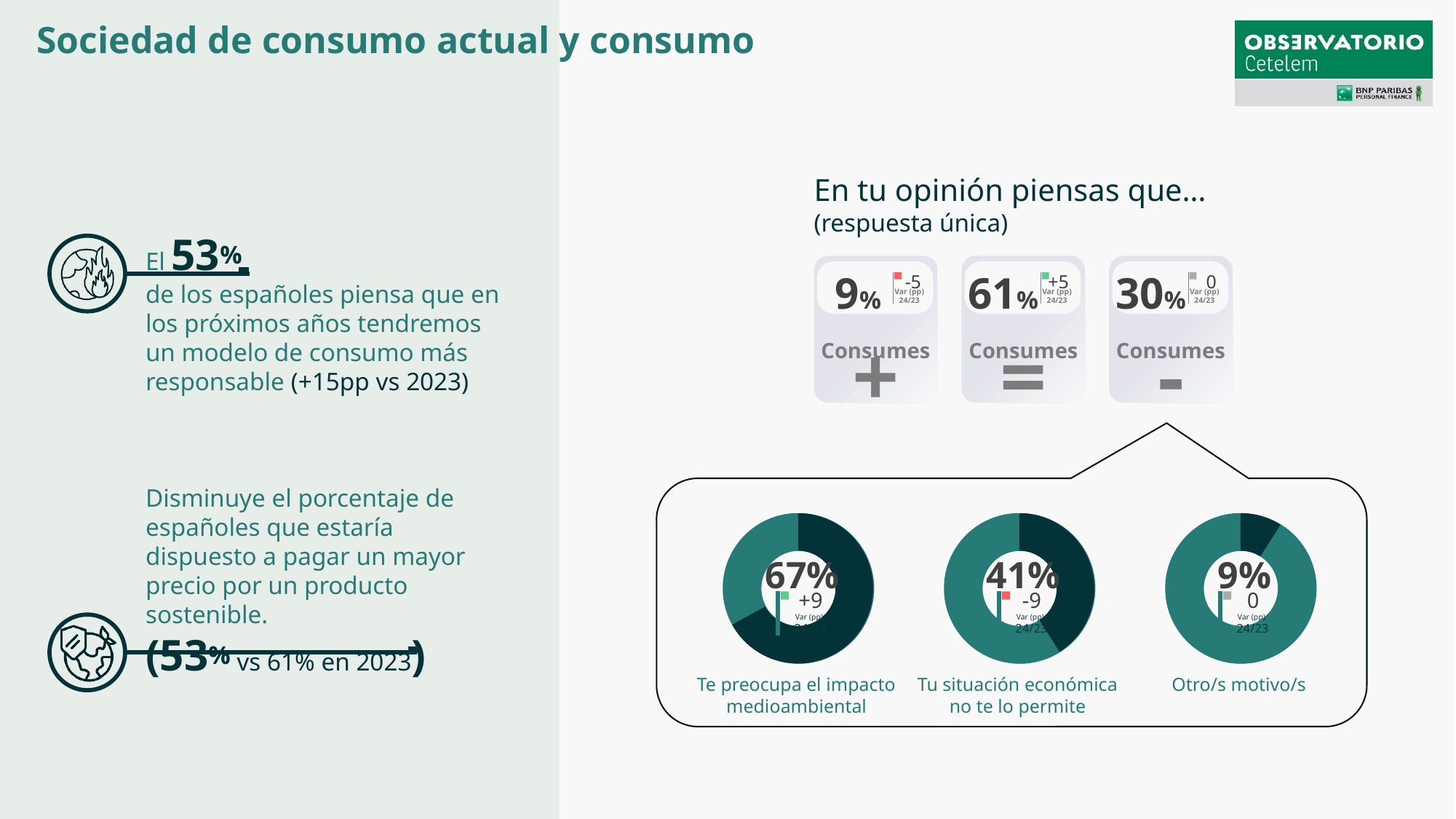
Which of the three donut charts shows the highest percentage? Te preocupa el impacto medioambiental In the donut chart 'Tu situación económica no te lo permite', what percentage is shown in the centre? 41% Which is larger: the percentage in the 'Tu situación económica no te lo permite' donut or the 'Otro/s motivo/s' donut? Tu situación económica no te lo permite What kind of charts are shown inside the callout box at the bottom right of the slide? Donut (pie) charts How many donut charts are shown in the callout box? 3 What is the variation (Var pp 24/23) shown in the 'Otro/s motivo/s' donut chart? 0 What is the variation (Var pp 24/23) shown in the 'Te preocupa el impacto medioambiental' donut chart? +9 What is the difference in percentage points between the 'Te preocupa el impacto medioambiental' donut and the 'Tu situación económica no te lo permite' donut? 26 In the donut chart 'Te preocupa el impacto medioambiental', what percentage is shown in the centre? 67% Which of the three donut charts shows the lowest percentage? Otro/s motivo/s In the donut chart 'Otro/s motivo/s', what percentage is shown in the centre? 9% What is the variation (Var pp 24/23) shown in the 'Tu situación económica no te lo permite' donut chart? -9